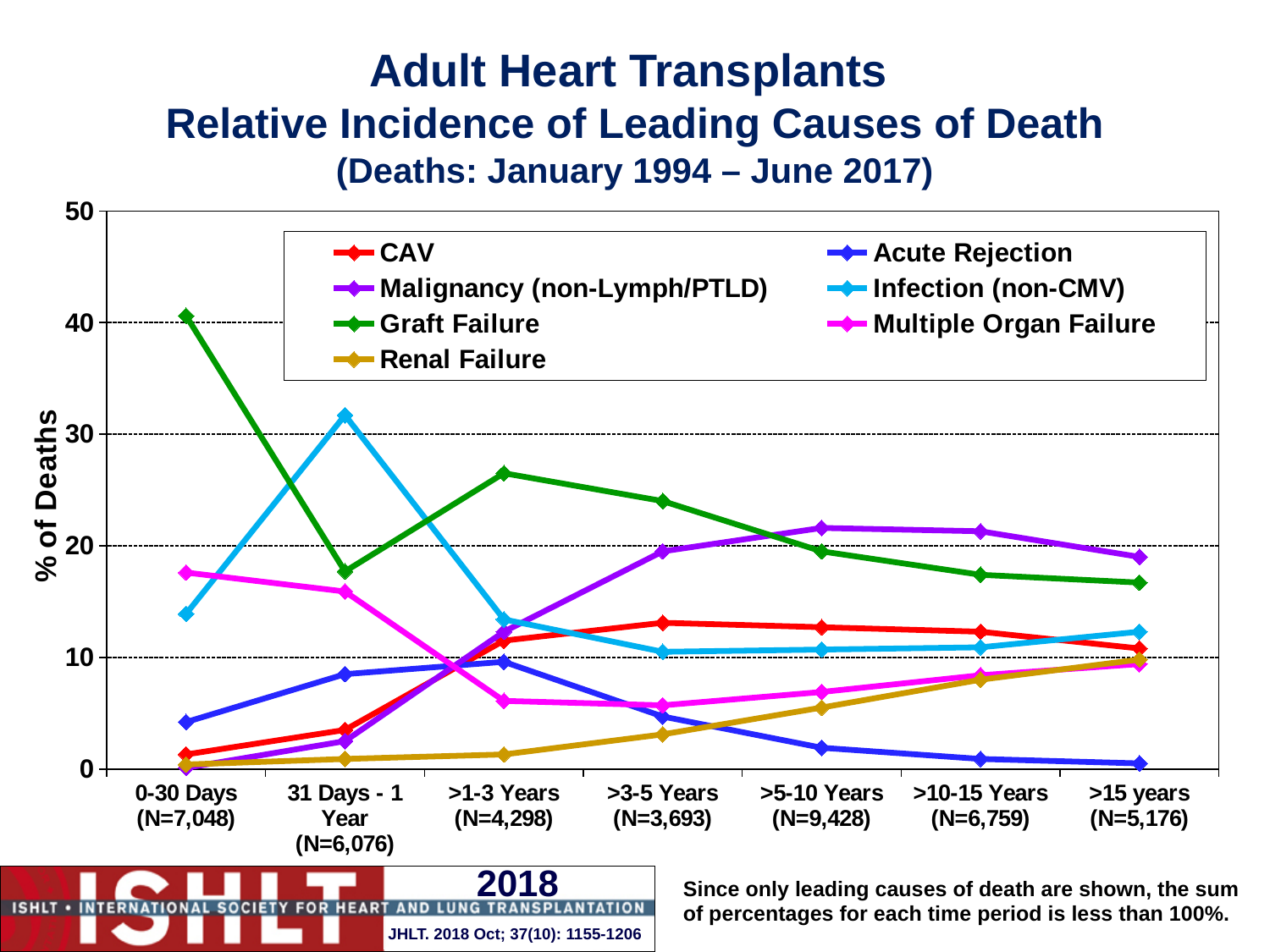
How many time periods are shown along the x axis? 7 What is the label of the y axis? % of Deaths Is the value for Acute Rejection in the >15 years period greater or less than 10? less Is the value for Graft Failure in the 0-30 Days period greater or less than 30? greater Which cause of death has the highest percentage in the >15 years period? Malignancy (non-Lymph/PTLD) In the >5-10 Years period, which is larger: Malignancy (non-Lymph/PTLD) or Graft Failure? Malignancy (non-Lymph/PTLD) How many series does the legend list? 7 What kind of chart is shown on the slide? line chart Does the Renal Failure line rise or fall across the time periods from 0-30 Days to >15 years? rise Which cause of death has the lowest percentage in the >15 years period? Acute Rejection Which cause of death has the highest percentage in the 0-30 Days period? Graft Failure Is the value for Infection (non-CMV) in the 31 Days - 1 Year period greater or less than 20? greater